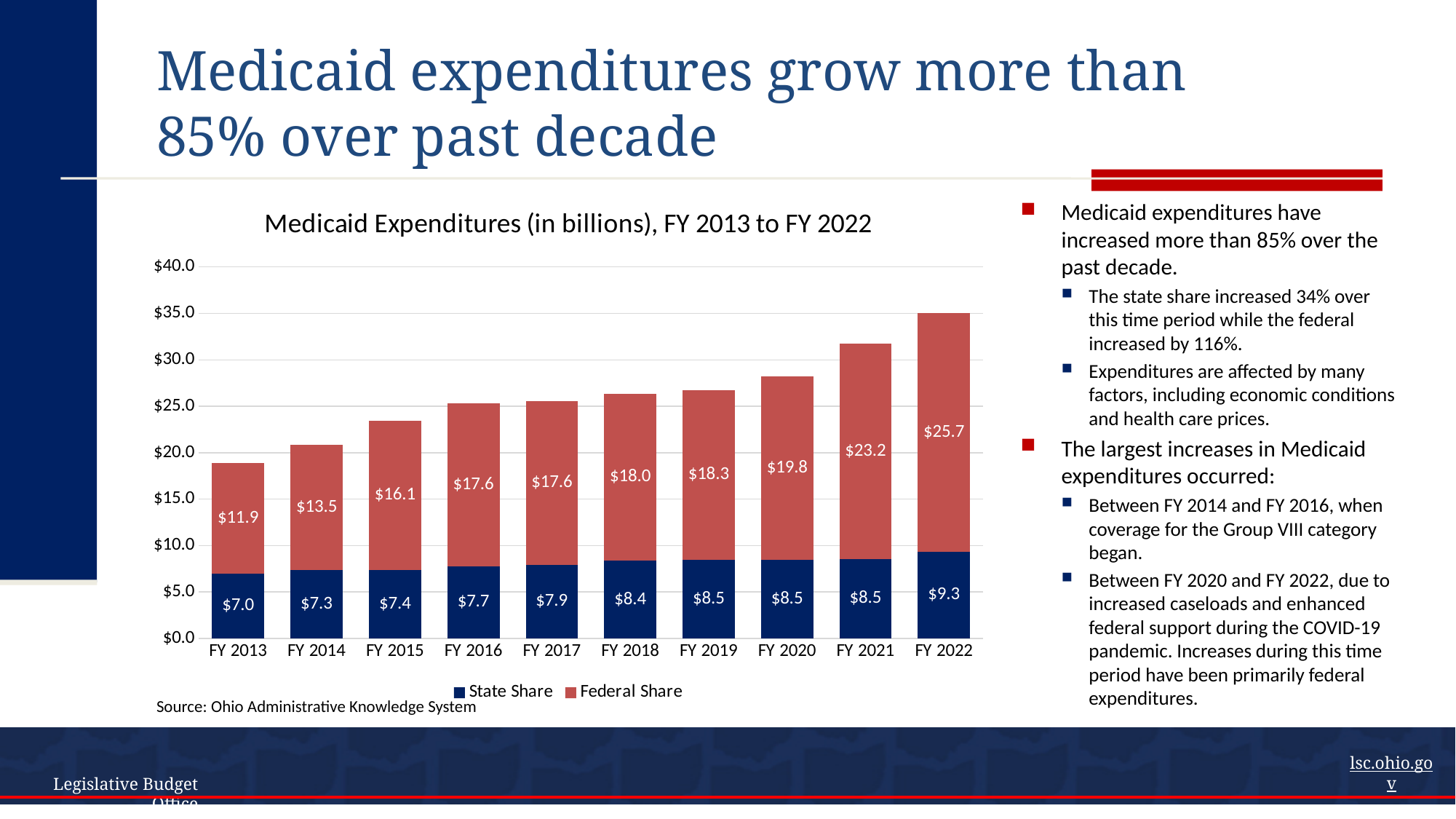
How many fiscal years are shown on the x axis? 10 What is the total of the stacked bar for FY 2013? $18.9 What kind of chart is shown on the slide? Stacked bar chart Is the total stacked bar for FY 2021 greater or less than $30.0? greater Do the Federal Share values generally rise or fall from FY 2013 to FY 2022? Rise What is the difference between the Federal Share in FY 2022 and the Federal Share in FY 2013? $13.8 How many series does the legend list? 2 Which is larger, the Federal Share in FY 2015 or the Federal Share in FY 2020? FY 2020 Which fiscal year has the highest Federal Share? FY 2022 What is the State Share value for FY 2016? $7.7 Which fiscal year has the lowest State Share? FY 2013 What is the Federal Share value for FY 2021? $23.2